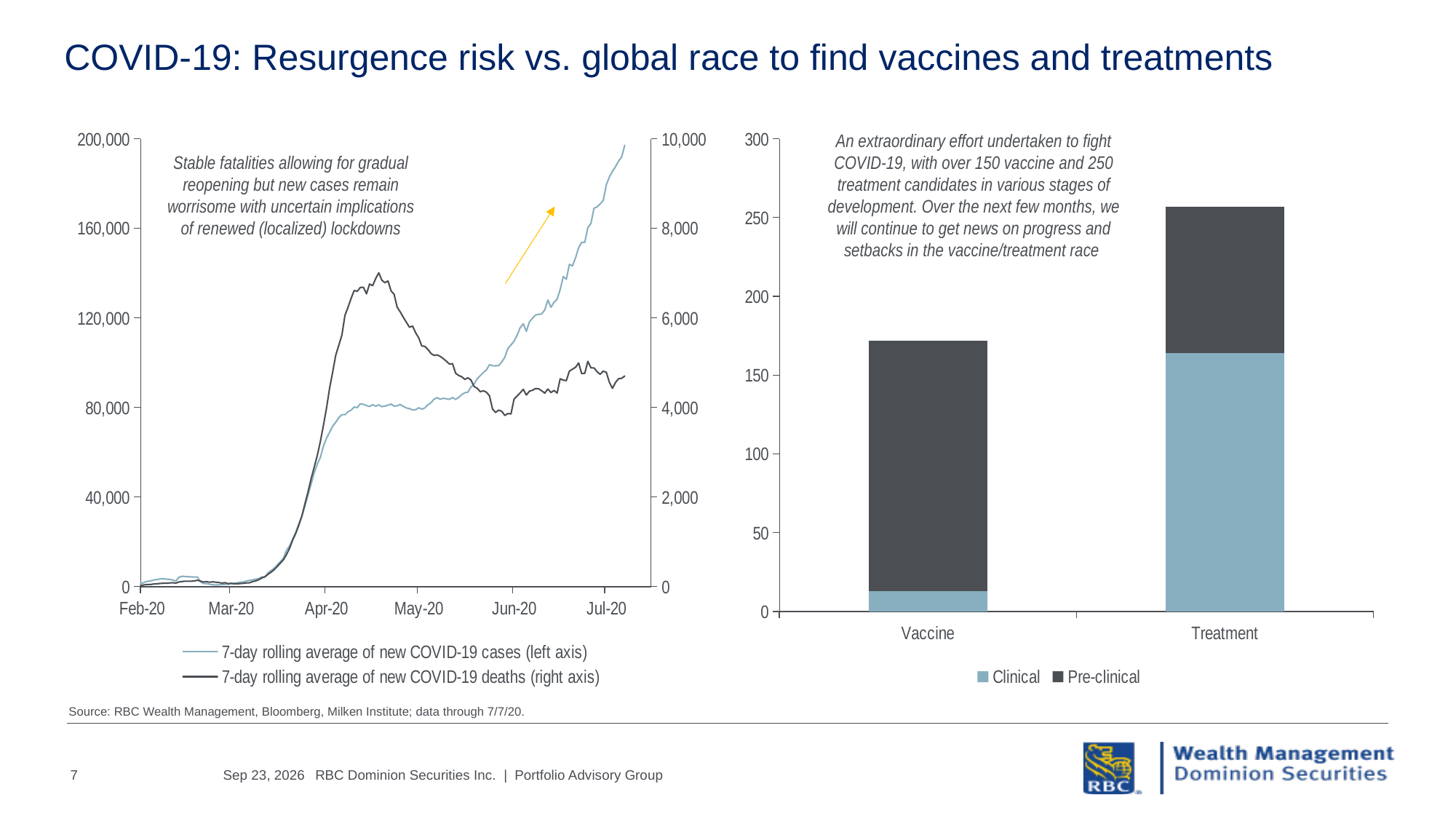
In the left chart, does the 7-day rolling average of new COVID-19 cases rise or fall between Jun-20 and Jul-20? Rise How many series does the legend of the left chart list? 2 In the right chart, which segment of the Treatment bar is larger, Clinical or Pre-clinical? Clinical In the right chart, which category has the taller stacked bar, Vaccine or Treatment? Treatment In the left chart, is the peak of the 7-day rolling average of new COVID-19 deaths greater or less than 6,000? greater In the right chart, is the total height of the Treatment bar greater or less than 250? greater How many categories are shown on the x axis of the right chart? 2 In the right chart, is the total height of the Vaccine bar greater or less than 150? greater How many series does the legend of the right chart list? 2 What kind of chart is the left chart showing 7-day rolling averages of new COVID-19 cases and deaths? Line chart What kind of chart is the right chart showing Vaccine and Treatment candidates? Bar chart